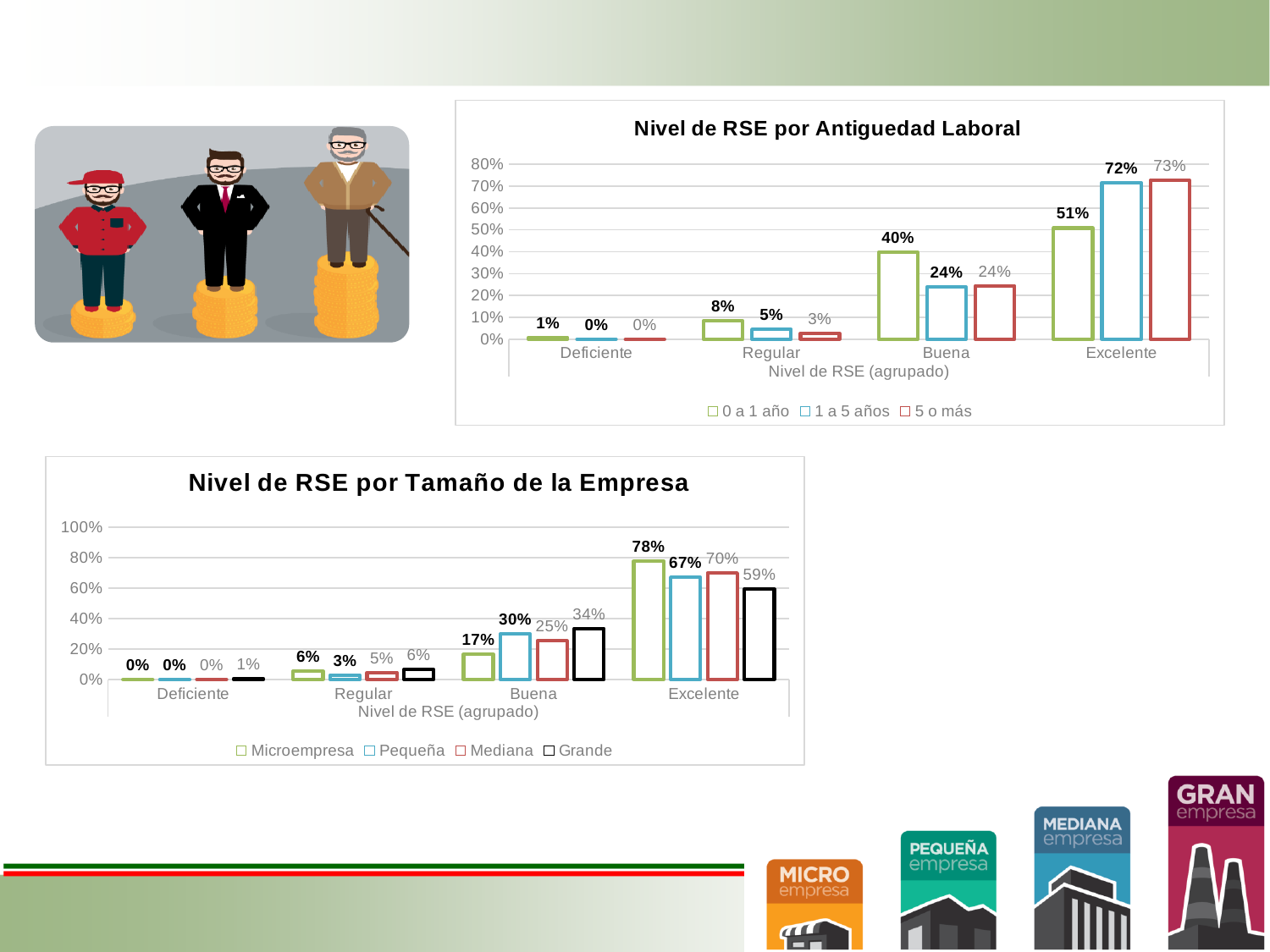
In the chart 'Nivel de RSE por Tamaño de la Empresa', what is the value for 'Grande' in the 'Buena' category? 34% In the chart 'Nivel de RSE por Antiguedad Laboral', what is the value for '0 a 1 año' in the 'Buena' category? 40% In the chart 'Nivel de RSE por Tamaño de la Empresa', which series has the highest value in the 'Excelente' category? Microempresa In the chart 'Nivel de RSE por Tamaño de la Empresa', what is the difference between 'Microempresa' and 'Grande' in the 'Excelente' category? 19% In the chart 'Nivel de RSE por Antiguedad Laboral', which category has the highest value for '1 a 5 años'? Excelente In the chart 'Nivel de RSE por Tamaño de la Empresa', which is larger in the 'Buena' category: 'Pequeña' or 'Mediana'? Pequeña What kind of chart is 'Nivel de RSE por Tamaño de la Empresa'? Bar chart In the chart 'Nivel de RSE por Antiguedad Laboral', what is the value for '5 o más' in the 'Excelente' category? 73% In the chart 'Nivel de RSE por Antiguedad Laboral', what is the difference between '1 a 5 años' and '0 a 1 año' in the 'Excelente' category? 21% In the chart 'Nivel de RSE por Tamaño de la Empresa', how many categories are shown on the x axis? 4 In the chart 'Nivel de RSE por Antiguedad Laboral', how many series does the legend list? 3 In the chart 'Nivel de RSE por Antiguedad Laboral', what is the value for '5 o más' in the 'Regular' category? 3%